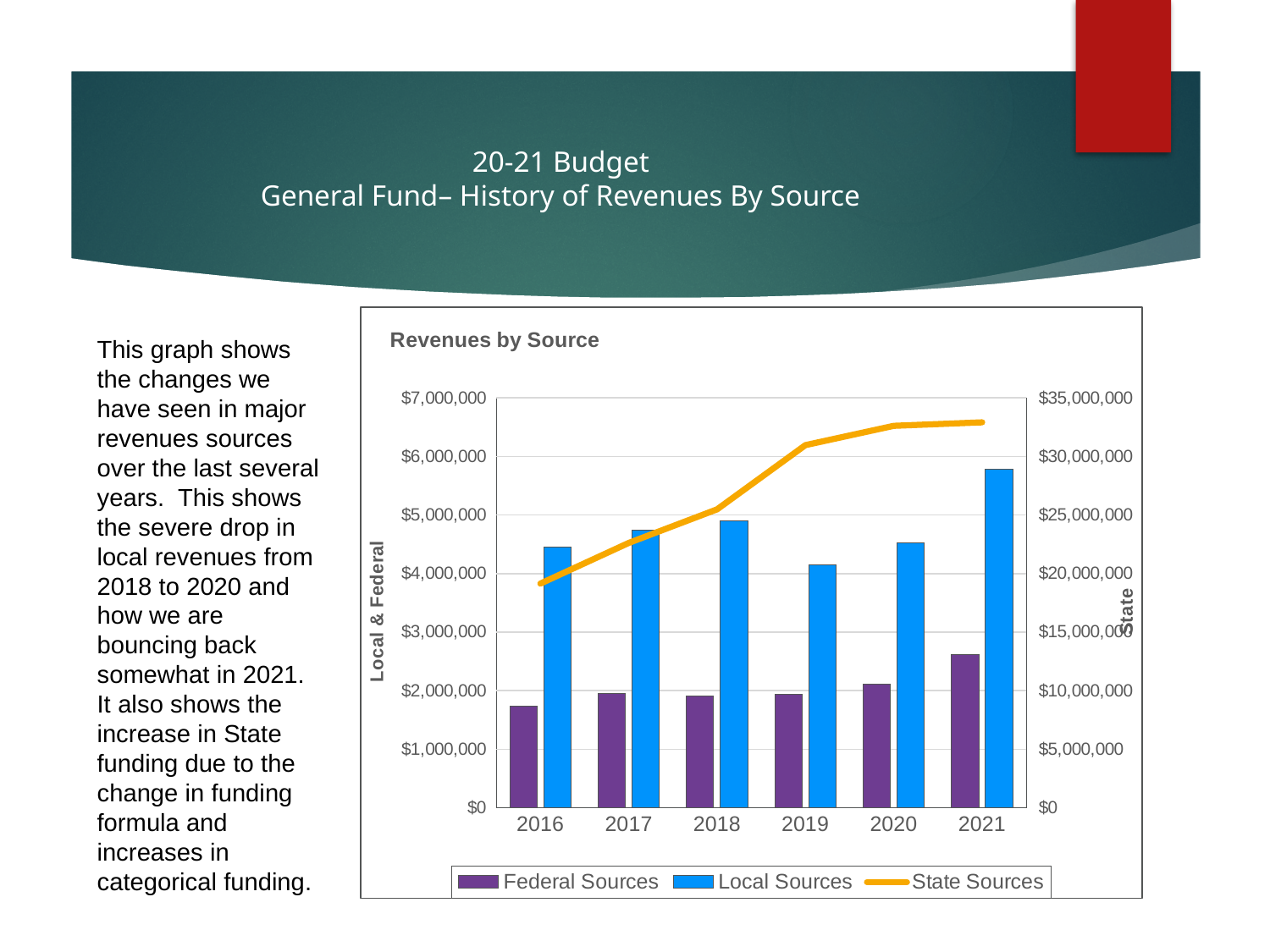
Is the value for Local Sources in 2021 greater or less than $5,000,000? greater Do State Sources rise or fall from 2016 to 2021? rise Is the value for Federal Sources in 2016 greater or less than $2,000,000? less What kind of chart is shown on the slide? A combined bar and line chart Which is larger, Local Sources in 2018 or Local Sources in 2019? 2018 How many series does the legend of the Revenues by Source chart list? 3 In which year are Federal Sources highest? 2021 Is the value for State Sources in 2021 greater or less than $30,000,000? greater In which year are Local Sources highest? 2021 In which year are Local Sources lowest? 2019 How many years are shown on the x axis of the Revenues by Source chart? 6 In which year are Federal Sources lowest? 2016